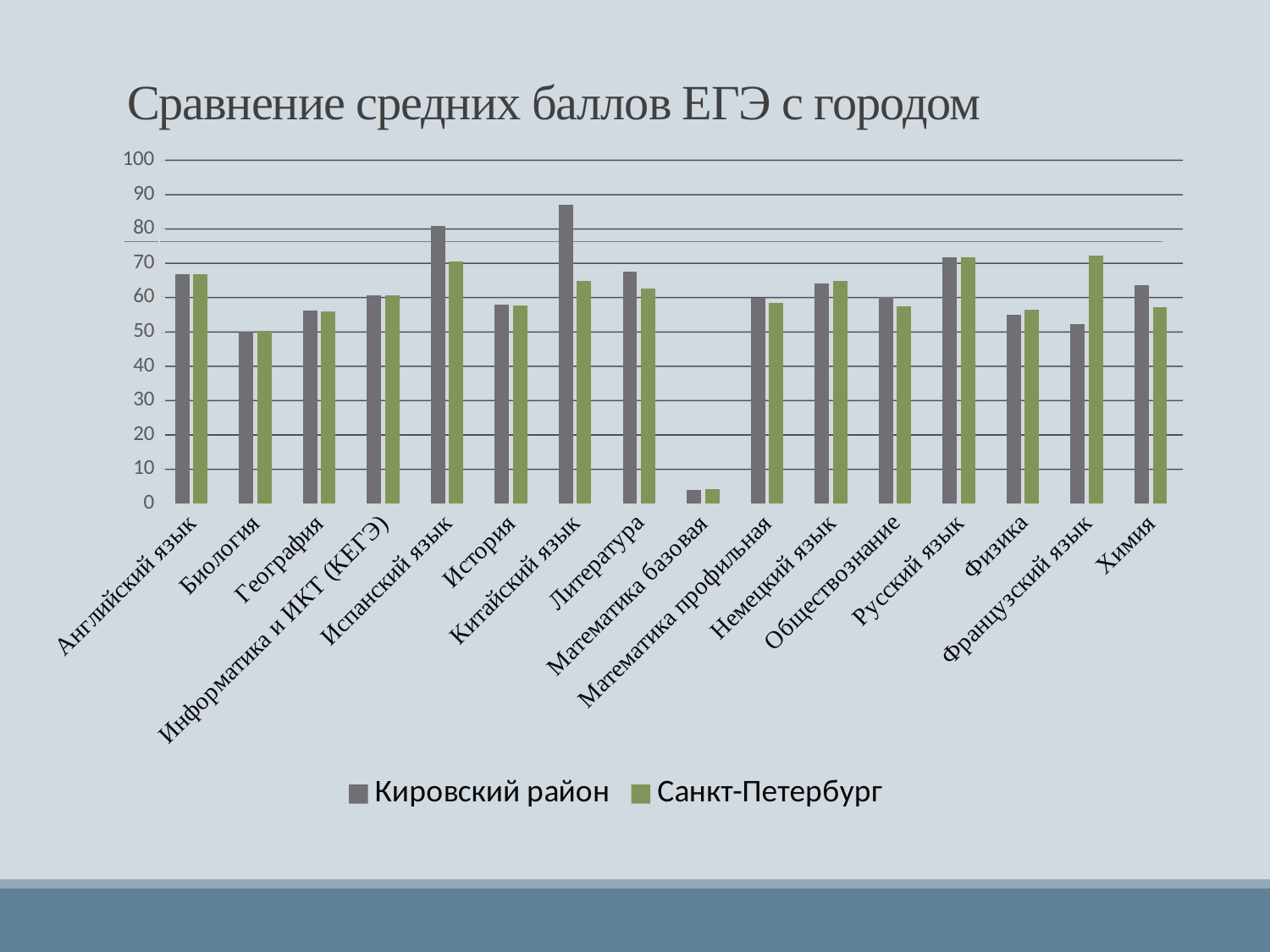
Is the value for Испанский язык for Кировский район greater or less than 70? greater Which subject has the highest value for Кировский район? Китайский язык Which subject has the lowest value for Кировский район? Математика базовая How many subject categories are shown on the x axis? 16 What kind of chart is shown on the slide? bar chart For Испанский язык, which is larger: Кировский район or Санкт-Петербург? Кировский район For Китайский язык, which is larger: Кировский район or Санкт-Петербург? Кировский район Is the value for Математика базовая for Санкт-Петербург greater or less than 10? less What is the title of the chart? Сравнение средних баллов ЕГЭ с городом How many series does the legend list? 2 Which subject has the lowest value for Санкт-Петербург? Математика базовая For Французский язык, which is larger: Кировский район or Санкт-Петербург? Санкт-Петербург